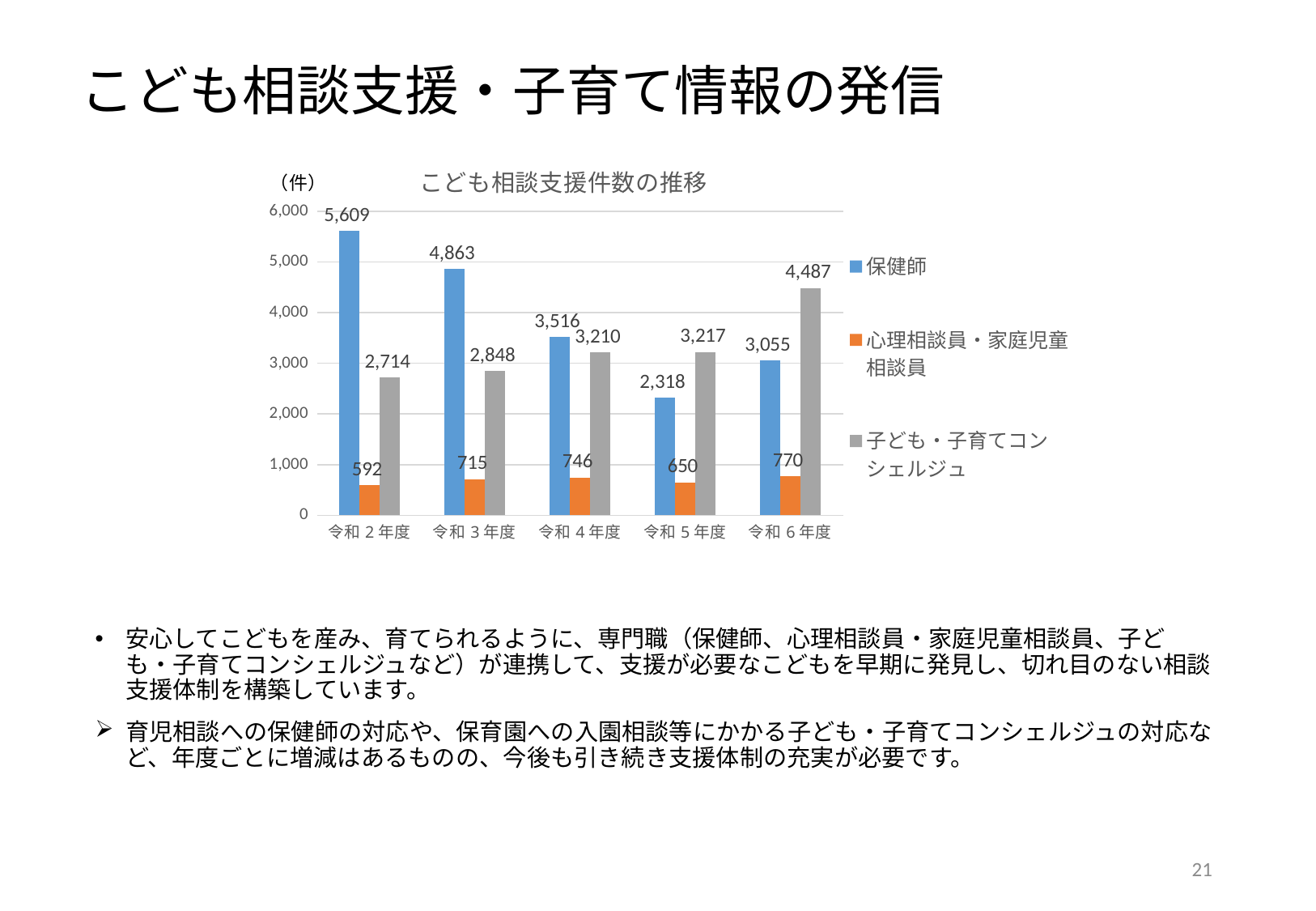
How many series does the legend list? 3 Does the value for 子ども・子育てコンシェルジュ rise or fall from 令和２年度 to 令和６年度? rise In which year is the value for 保健師 the lowest? 令和５年度 In which year is the value for 心理相談員・家庭児童相談員 the highest? 令和６年度 How many fiscal years are shown on the x axis? 5 Which is larger in 令和６年度, the value for 保健師 or the value for 子ども・子育てコンシェルジュ? 子ども・子育てコンシェルジュ What is the value for 心理相談員・家庭児童相談員 in 令和４年度? 746 What kind of chart is shown on the slide? bar chart Is the value for 保健師 in 令和５年度 greater or less than 3,000? less What is the value for 保健師 in 令和２年度? 5,609 What is the difference between the 保健師 values for 令和２年度 and 令和３年度? 746 What is the value for 子ども・子育てコンシェルジュ in 令和６年度? 4,487